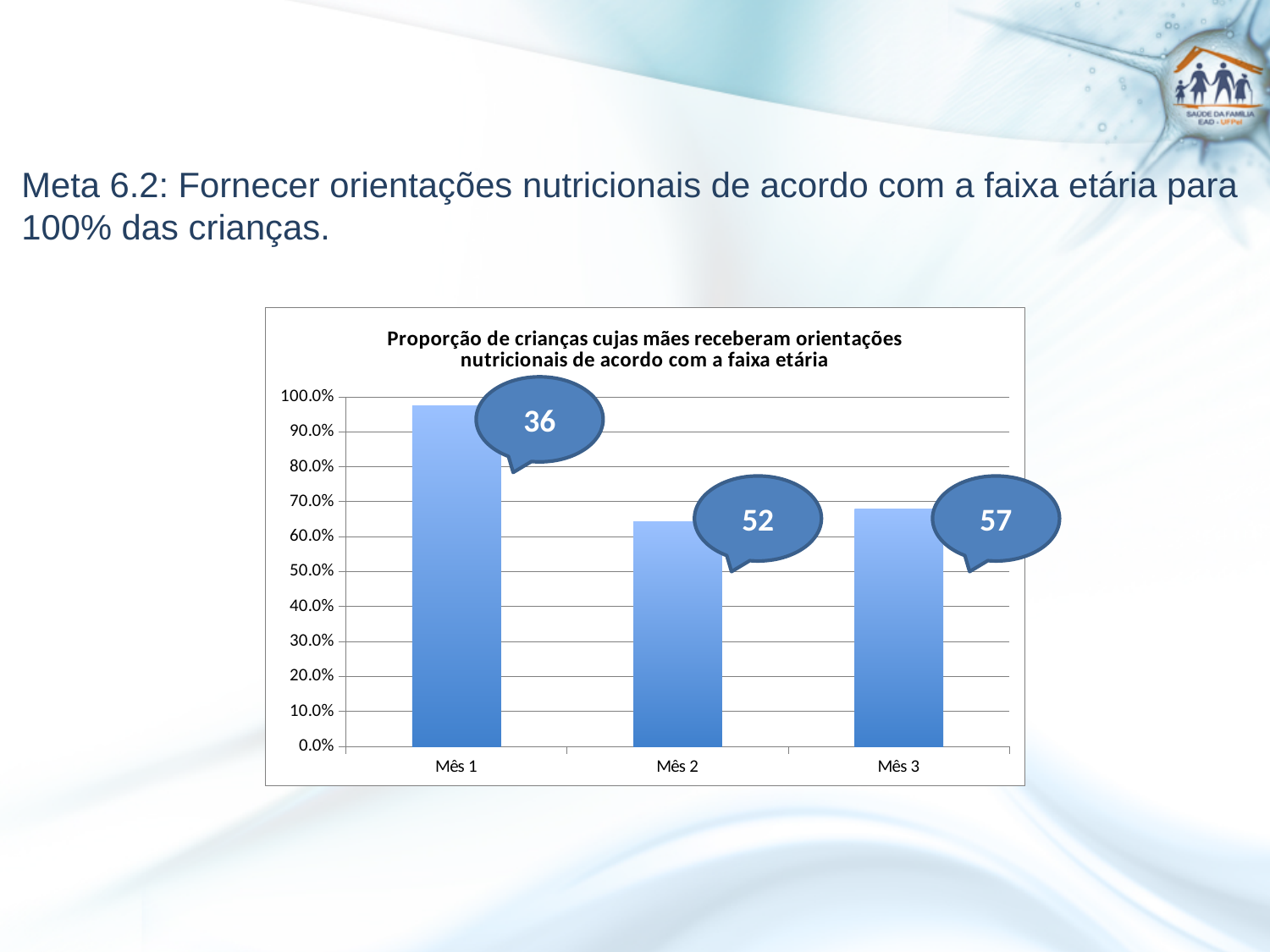
Does the value rise or fall from Mês 1 to Mês 2? fall What number is shown in the callout next to the Mês 2 bar? 52 Which month has the lowest bar in the chart? Mês 2 Is the value for Mês 2 greater or less than 70%? less How many categories (months) are shown on the x axis of the chart? 3 What is the title of the chart? Proporção de crianças cujas mães receberam orientações nutricionais de acordo com a faixa etária Is the value for Mês 1 greater or less than 90%? greater Which has a larger value, Mês 2 or Mês 3? Mês 3 Is the value for Mês 3 greater or less than 60%? greater Which month has the highest bar in the chart? Mês 1 What kind of chart is shown on the slide? bar chart